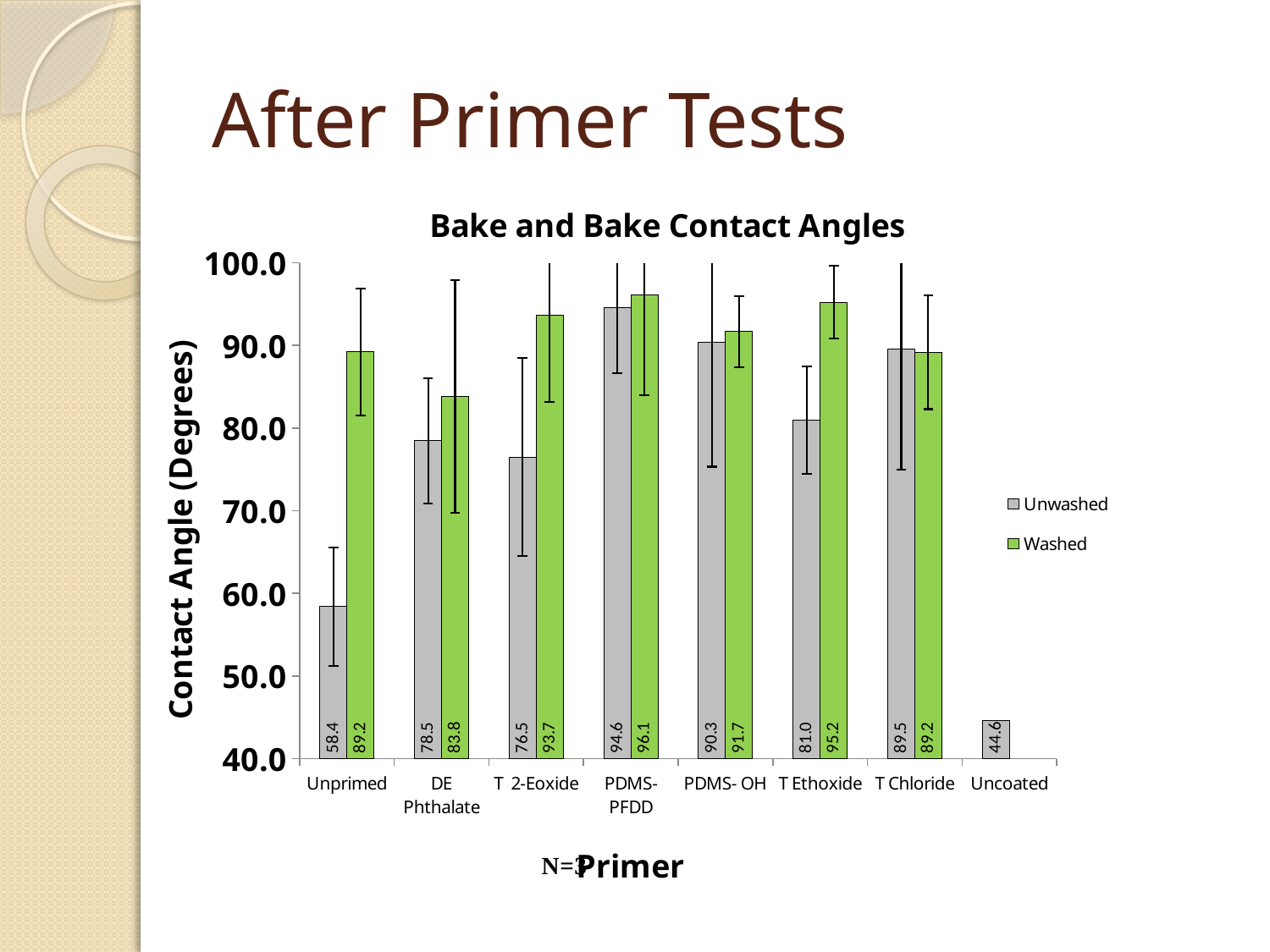
How many series does the legend list? 2 Which is larger for T Chloride, the Unwashed or the Washed value? Unwashed Is the Unwashed value for DE Phthalate greater or less than 80.0? less Which category has the lowest Unwashed contact angle? Uncoated Which primer has the highest Washed contact angle? PDMS-PFDD What is the title of the chart? Bake and Bake Contact Angles What is the difference between the Washed and Unwashed values for Unprimed? 30.8 What is the Washed contact angle for T Ethoxide? 95.2 What is the Unwashed contact angle for Unprimed? 58.4 How many primer categories are shown on the x axis? 8 What kind of chart is shown? bar chart What is the Unwashed value for Uncoated? 44.6